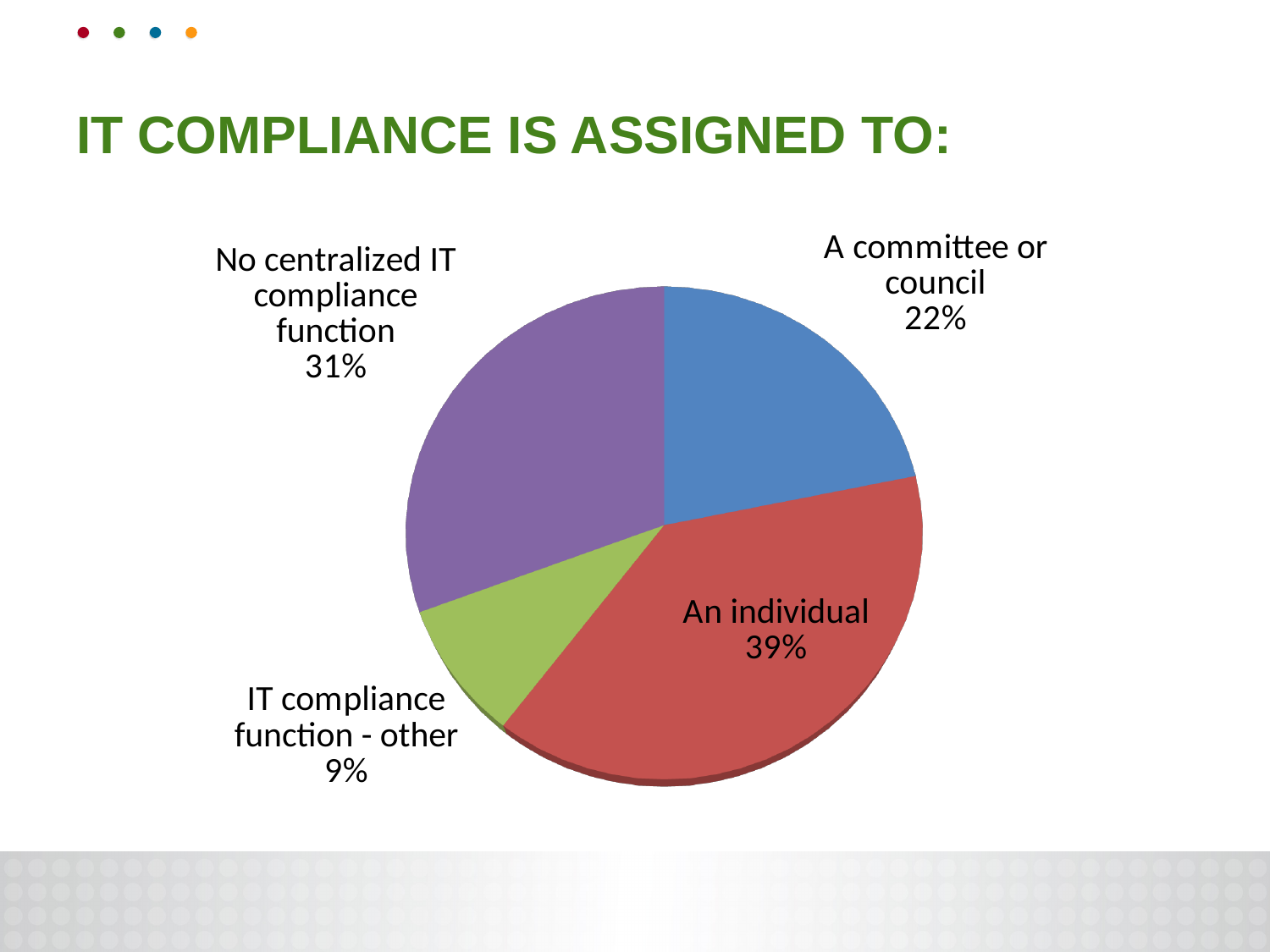
Which category has the smallest slice of the pie? IT compliance function - other What share of the pie is labelled "IT compliance function - other"? 9% What kind of chart is shown on the slide? pie chart What colour is the slice for "An individual"? red What share of the pie is labelled "A committee or council"? 22% Which is larger: the share for "No centralized IT compliance function" or the share for "A committee or council"? No centralized IT compliance function What is the difference in percentage points between "An individual" and "A committee or council"? 17 Which category has the largest slice of the pie? An individual How many slices does the pie chart have? 4 What is the title of the slide containing the pie chart? IT COMPLIANCE IS ASSIGNED TO: What share of the pie is labelled "No centralized IT compliance function"? 31%